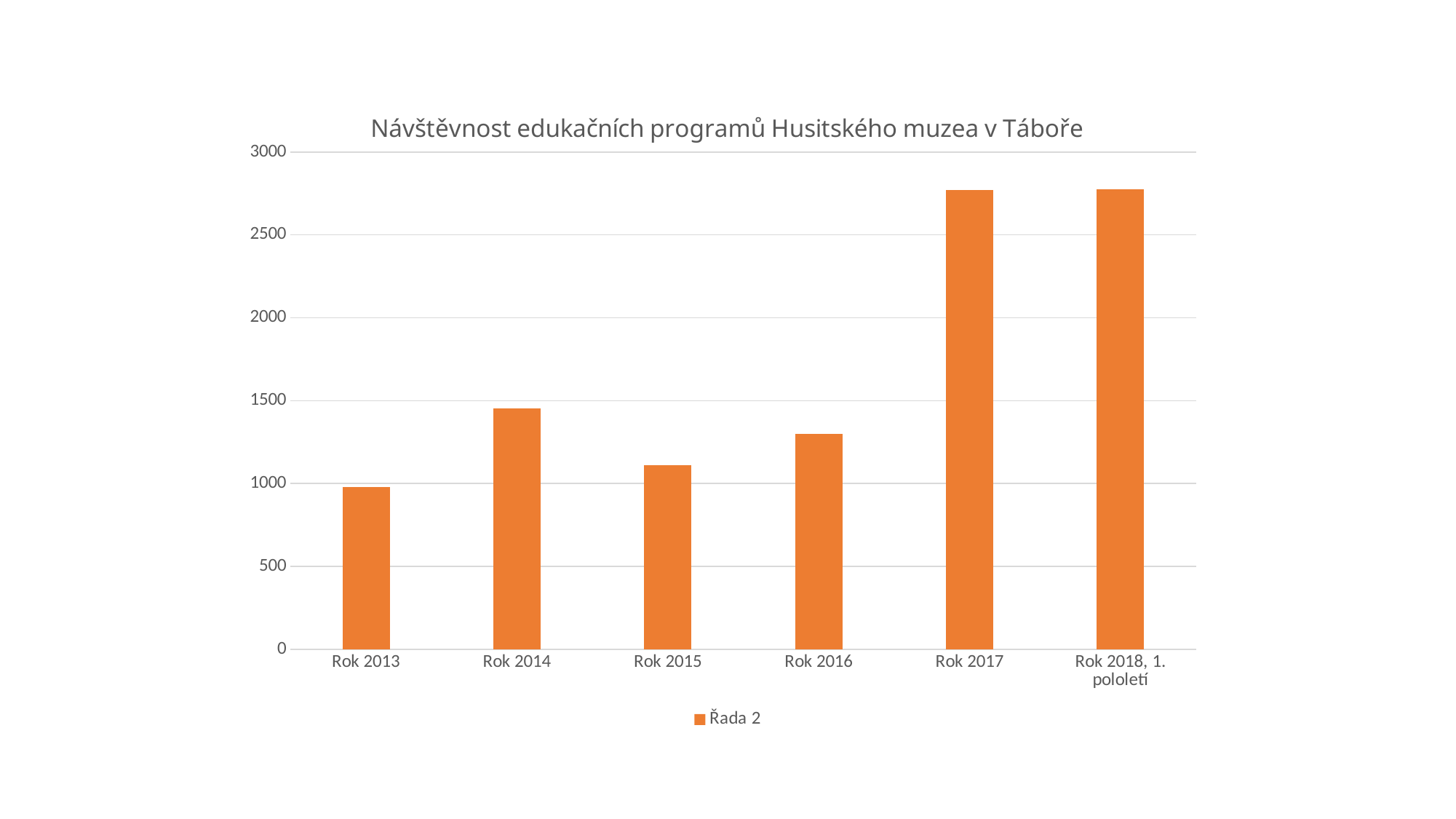
What is the title of the chart? Návštěvnost edukačních programů Husitského muzea v Táboře Between Rok 2014 and Rok 2015, does the value rise or fall? fall What kind of chart is shown on the slide? bar chart Is the value for Rok 2014 greater or less than 1500? less How many series does the legend list? 1 Which is larger, the value for Rok 2014 or the value for Rok 2015? Rok 2014 Is the value for Rok 2016 greater or less than 1000? greater Which category has the lowest value? Rok 2013 What is the name of the series in the legend? Řada 2 Is the value for Rok 2017 greater or less than 2500? greater How many categories are shown on the x axis? 6